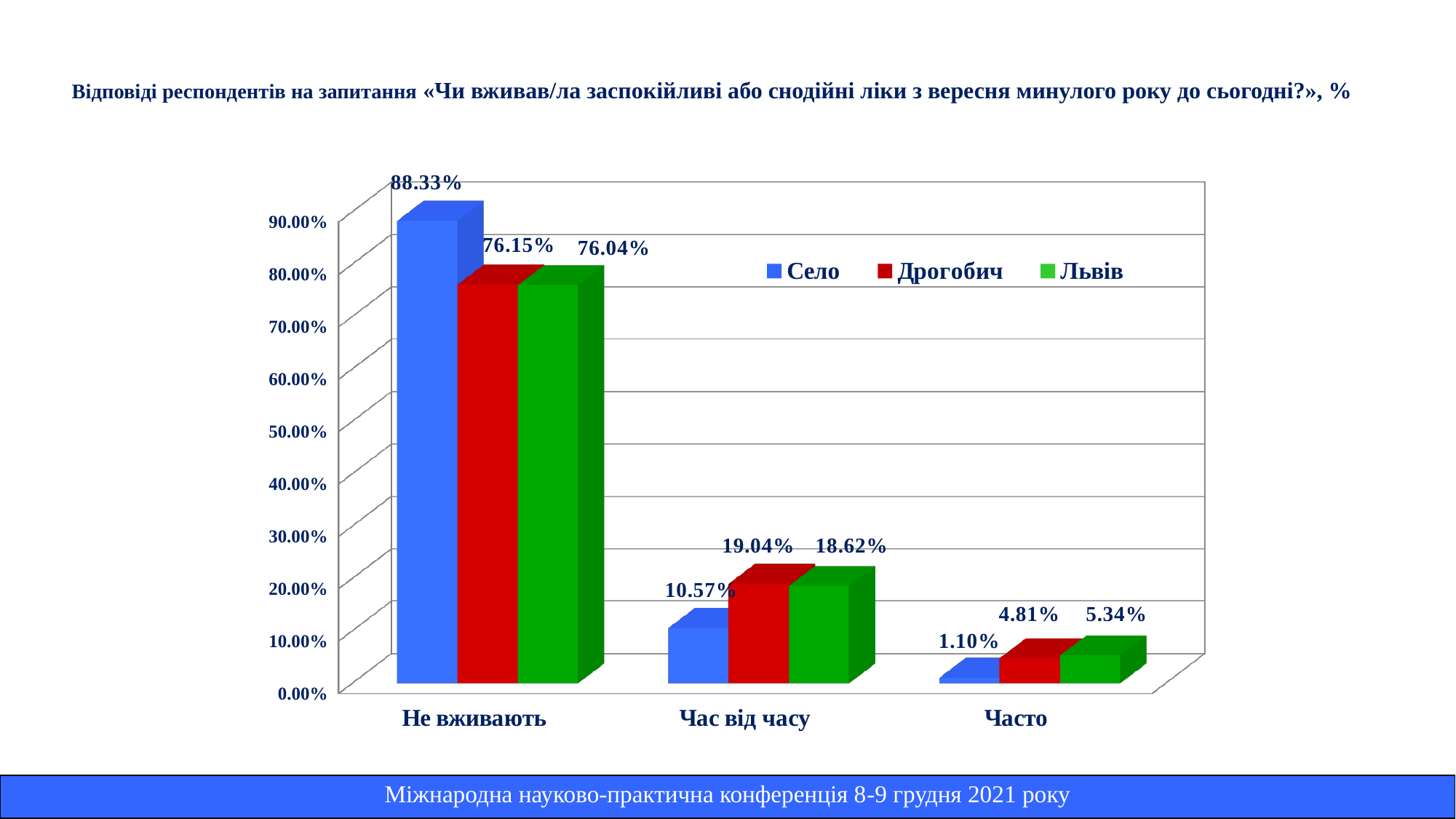
What is the value for Львів in the category Часто? 5.34% Which colour represents the series Львів in the legend? green Which is larger in the category Час від часу: the value for Село or the value for Львів? Львів Which series has the highest value in the category Не вживають? Село What type of chart is shown on the slide? bar chart How many categories are shown on the x axis? 3 What is the value for Дрогобич in the category Час від часу? 19.04% Which series has the lowest value in the category Часто? Село What is the value for Село in the category Не вживають? 88.33% How many series does the legend list? 3 Is the value for Дрогобич in the category Час від часу greater or less than 10.00%? greater What is the difference between the Село and Дрогобич values in the category Не вживають? 12.18%